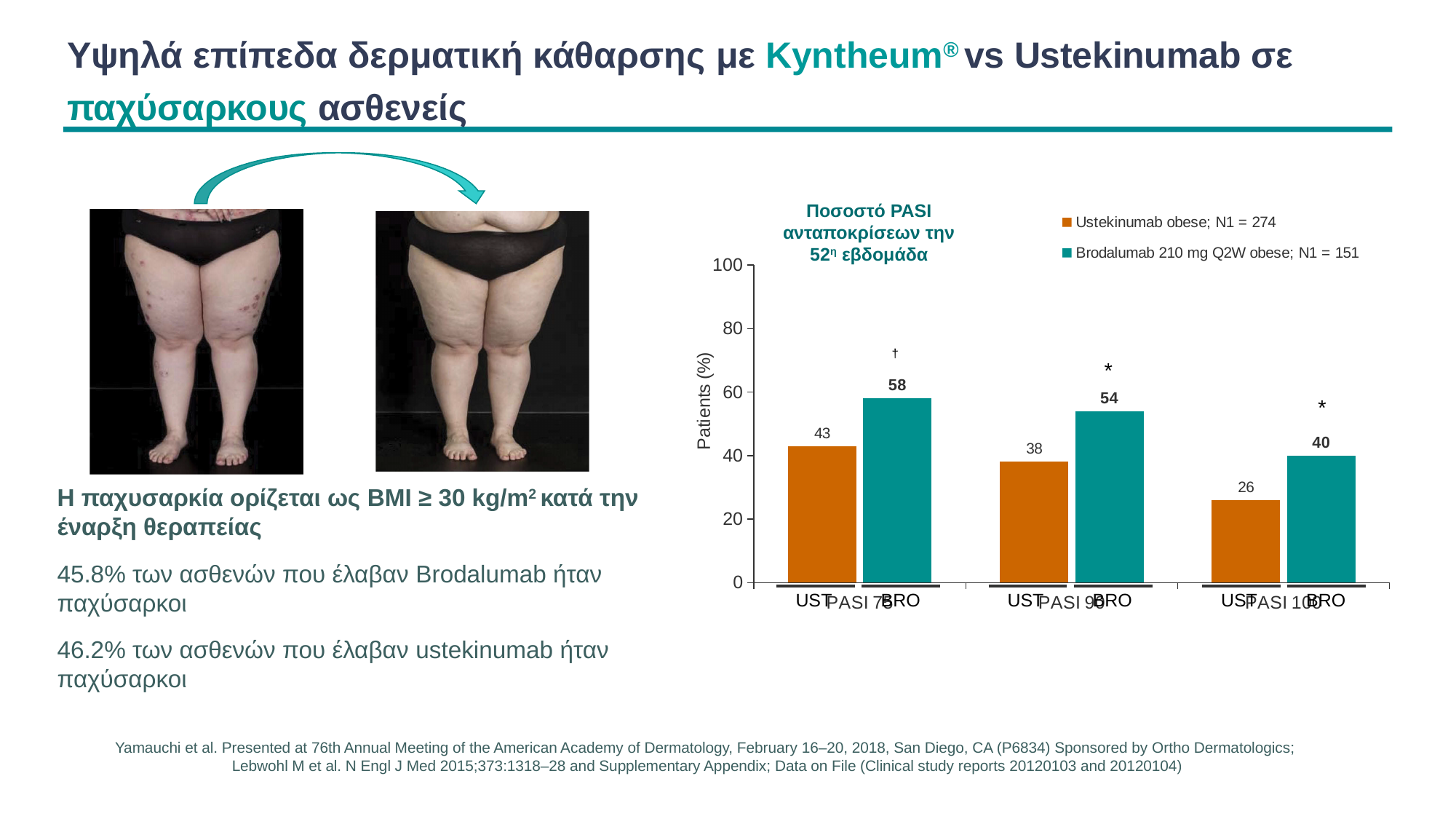
Which PASI category has the highest Brodalumab value? PASI 75 What type of chart is shown on the slide? Bar chart What is the Brodalumab value for PASI 75? 58 What is the Ustekinumab value for PASI 100? 26 What is the Brodalumab value for PASI 100? 40 What is the Ustekinumab value for PASI 90? 38 Which PASI category has the lowest Ustekinumab value? PASI 100 Do the Ustekinumab values rise or fall from PASI 75 to PASI 100? Fall What is the difference between the Brodalumab and Ustekinumab values for PASI 90? 16 For PASI 75, which is larger: the Ustekinumab value or the Brodalumab value? Brodalumab How many series does the chart legend list? 2 What is the label of the y axis? Patients (%)